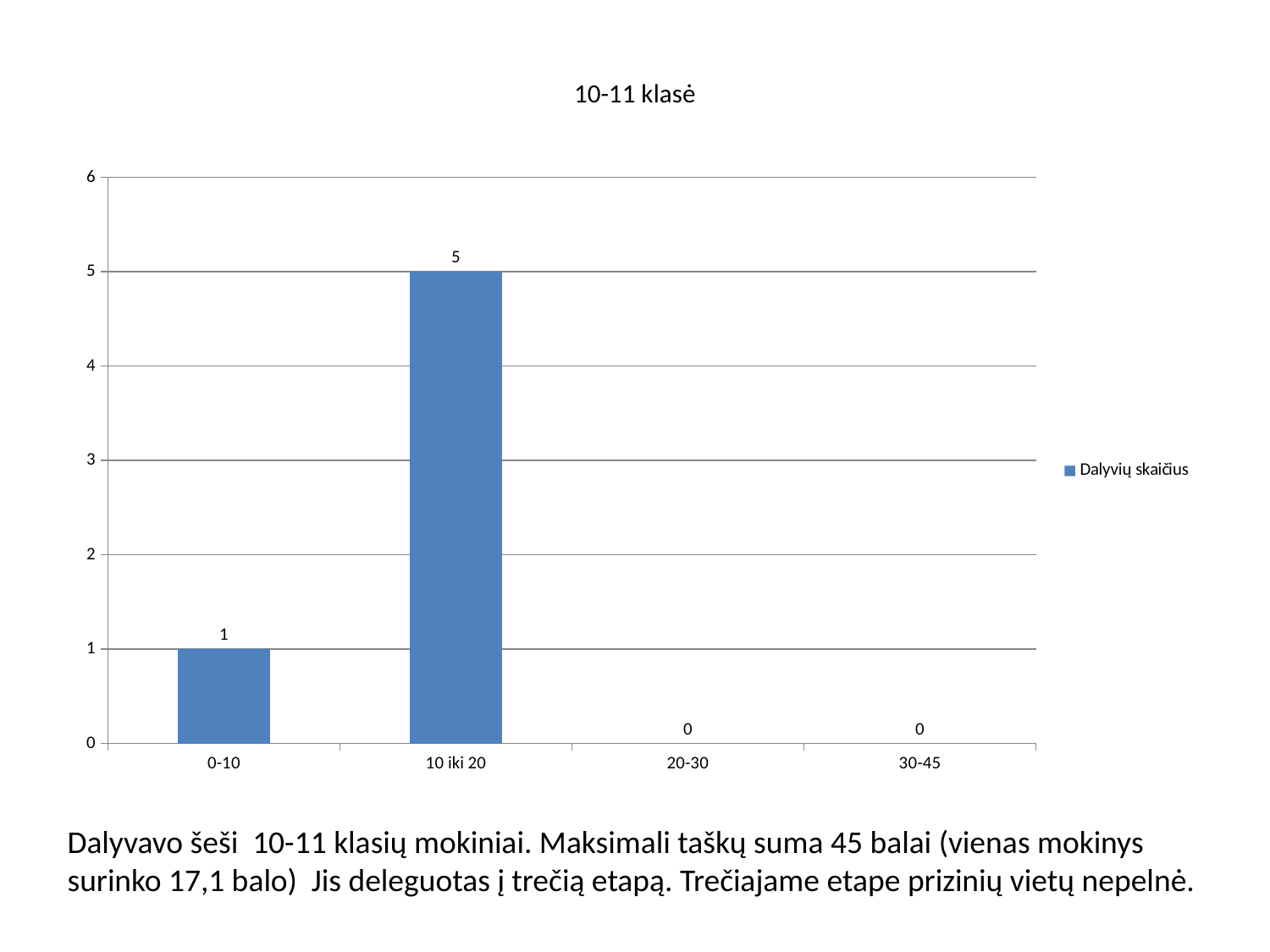
What is the title of the chart? 10-11 klasė What is the value for the 0-10 category? 1 Which is larger, the value for 0-10 or the value for 10 iki 20? 10 iki 20 What is the value for the 20-30 category? 0 How many categories are shown on the x axis? 4 How many series does the legend list? 1 What is the name of the series in the legend? Dalyvių skaičius Which category has the highest value? 10 iki 20 What is the value for the 30-45 category? 0 What is the difference between the values for 10 iki 20 and 0-10? 4 What is the value for the 10 iki 20 category? 5 What kind of chart is shown on the slide? bar chart